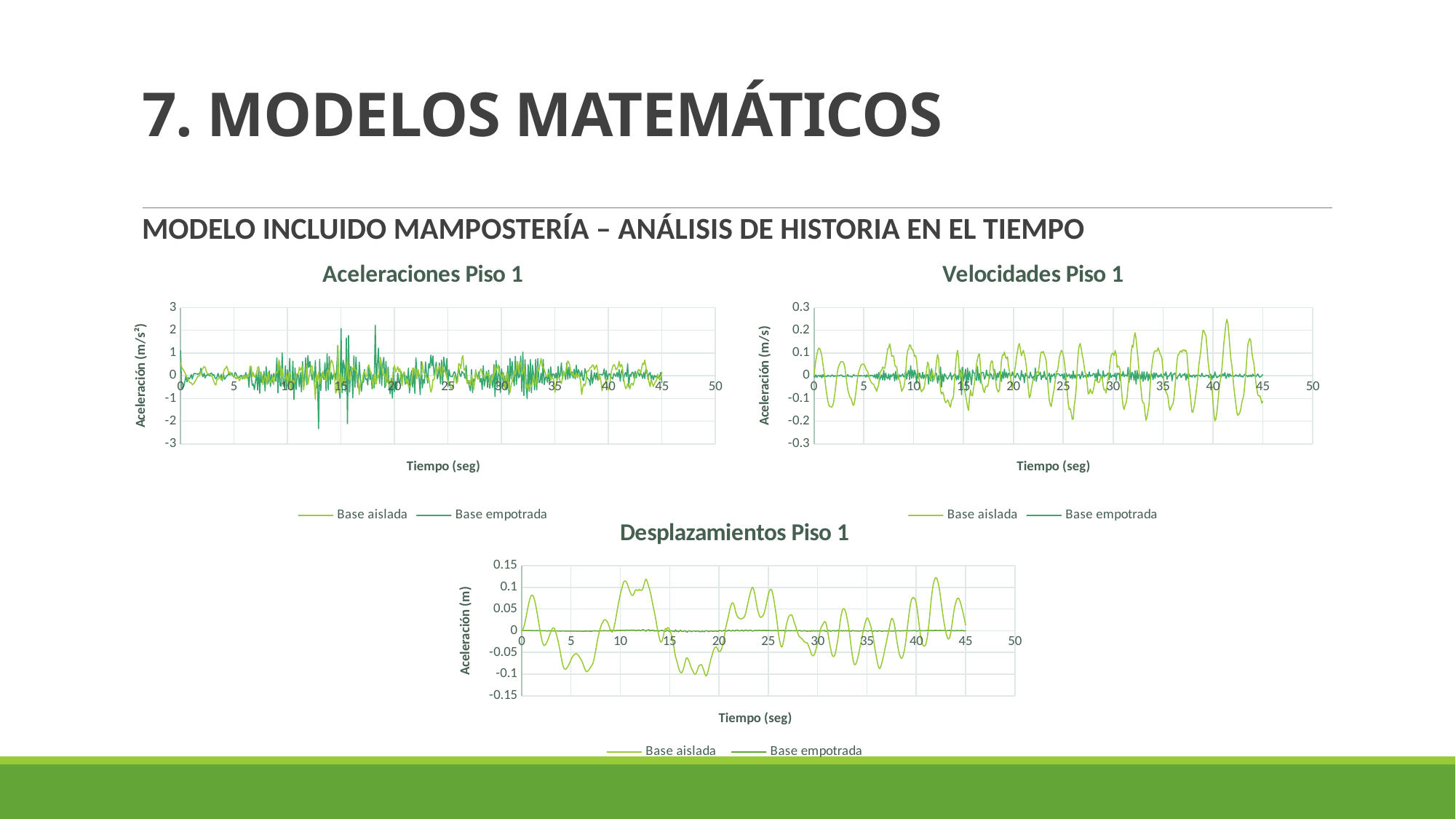
How many series does the legend of the 'Velocidades Piso 1' chart list? 2 In the 'Aceleraciones Piso 1' chart, is the highest peak of Base empotrada greater or less than 2? greater What are the two series named in the legend of the 'Desplazamientos Piso 1' chart? Base aislada, Base empotrada In the 'Velocidades Piso 1' chart, which series reaches larger amplitudes, Base aislada or Base empotrada? Base aislada In the 'Desplazamientos Piso 1' chart, is the peak value of Base aislada near 42 seconds greater or less than 0.1? greater In the 'Desplazamientos Piso 1' chart, which series shows larger displacements, Base aislada or Base empotrada? Base aislada In the 'Velocidades Piso 1' chart, is the value of Base empotrada at 30 seconds greater or less than 0.1? less How many charts are shown on the slide? 3 What kind of chart is the 'Aceleraciones Piso 1' chart? line chart What is the x-axis title of the 'Velocidades Piso 1' chart? Tiempo (seg)